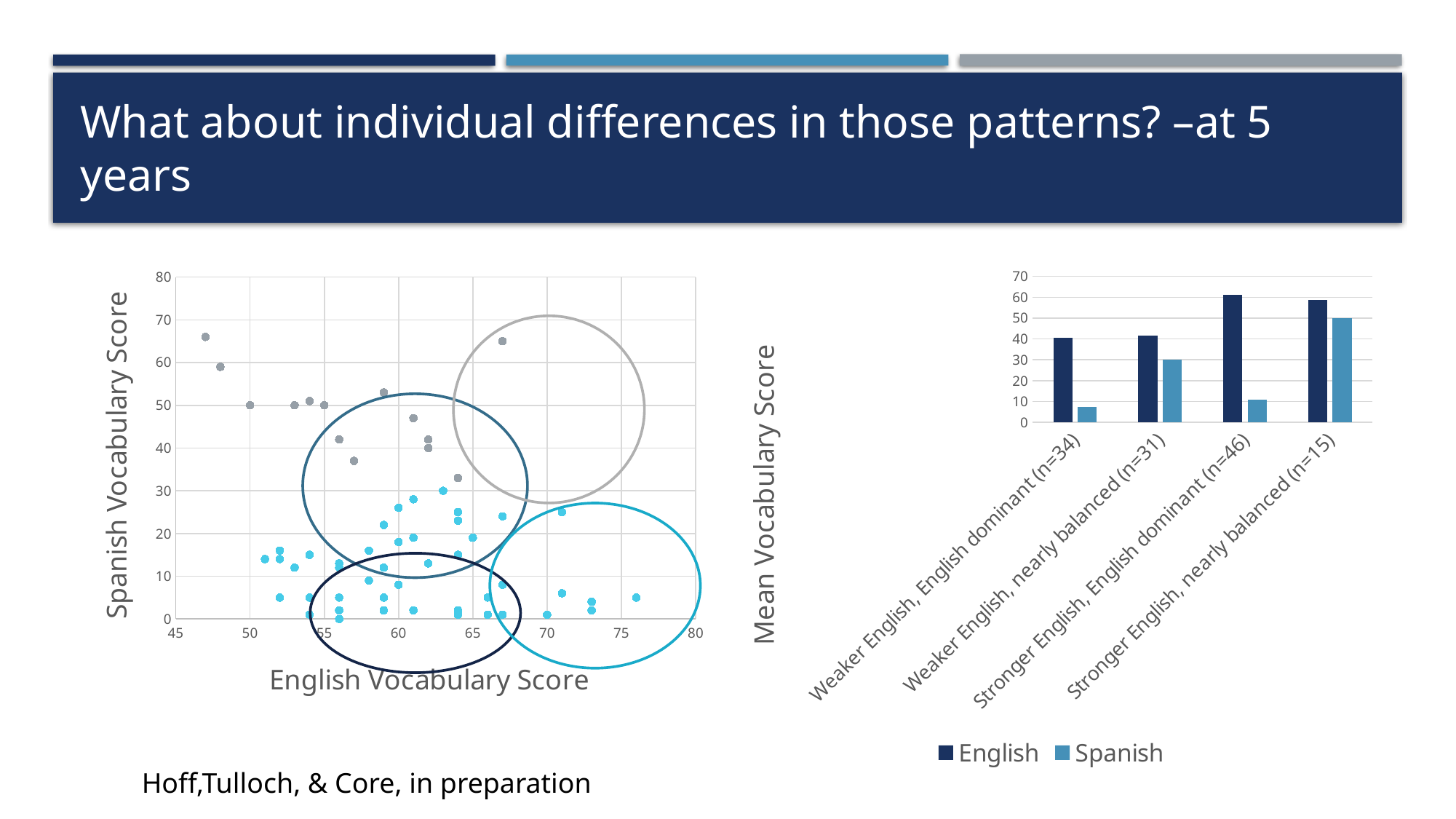
In the bar chart on the right, which group has the lowest Spanish mean vocabulary score? Weaker English, English dominant (n=34) In the bar chart on the right, is the Spanish value for Stronger English, nearly balanced (n=15) greater or less than 40? greater In the bar chart on the right, for the Weaker English, nearly balanced (n=31) group, which is larger: the English or the Spanish value? English In the bar chart on the right, how many groups are shown on the x axis? 4 What kind of chart is the chart on the left of the slide? scatter plot In the scatter plot on the left, what is the label of the y axis? Spanish Vocabulary Score In the bar chart on the right, how many series does the legend list? 2 In the bar chart on the right, which group has the highest Spanish mean vocabulary score? Stronger English, nearly balanced (n=15) In the bar chart on the right, is the Spanish value for Weaker English, English dominant (n=34) greater or less than 10? less In the bar chart on the right, is the English value for Stronger English, English dominant (n=46) greater or less than 50? greater What kind of chart is the chart on the right of the slide? bar chart In the scatter plot on the left, what is the label of the x axis? English Vocabulary Score